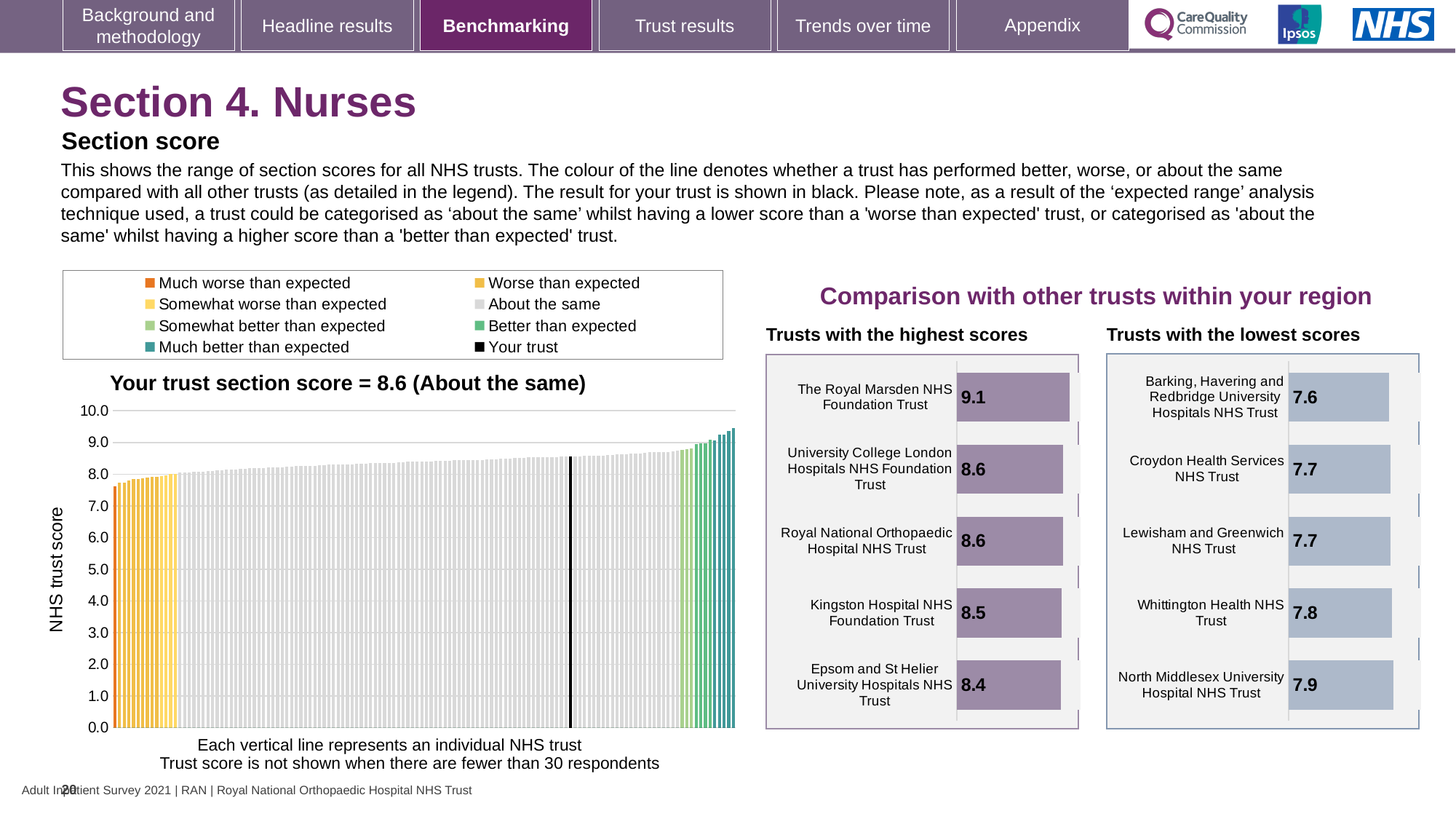
In the 'Trusts with the highest scores' chart, which has the higher score: The Royal Marsden NHS Foundation Trust or Kingston Hospital NHS Foundation Trust? The Royal Marsden NHS Foundation Trust In the 'Trusts with the highest scores' chart, which trust has the lowest score? Epsom and St Helier University Hospitals NHS Trust How many trusts are shown in the 'Trusts with the lowest scores' chart? 5 In the 'Trusts with the lowest scores' chart, which trust has the highest score? North Middlesex University Hospital NHS Trust In the main section score chart on the left, do the values rise or fall from left to right along the x axis? rise How many entries does the legend of the main section score chart list? 8 In the main section score chart on the left, what is the section score for your trust? 8.6 In the main section score chart on the left, is the value for your trust greater or less than 8.0? greater In the 'Trusts with the highest scores' chart, what is the score for The Royal Marsden NHS Foundation Trust? 9.1 In the 'Trusts with the lowest scores' chart, what is the difference between the scores of North Middlesex University Hospital NHS Trust and Barking, Havering and Redbridge University Hospitals NHS Trust? 0.3 In the 'Trusts with the highest scores' chart, what is the difference between the scores of The Royal Marsden NHS Foundation Trust and Epsom and St Helier University Hospitals NHS Trust? 0.7 In the 'Trusts with the lowest scores' chart, what is the score for Croydon Health Services NHS Trust? 7.7